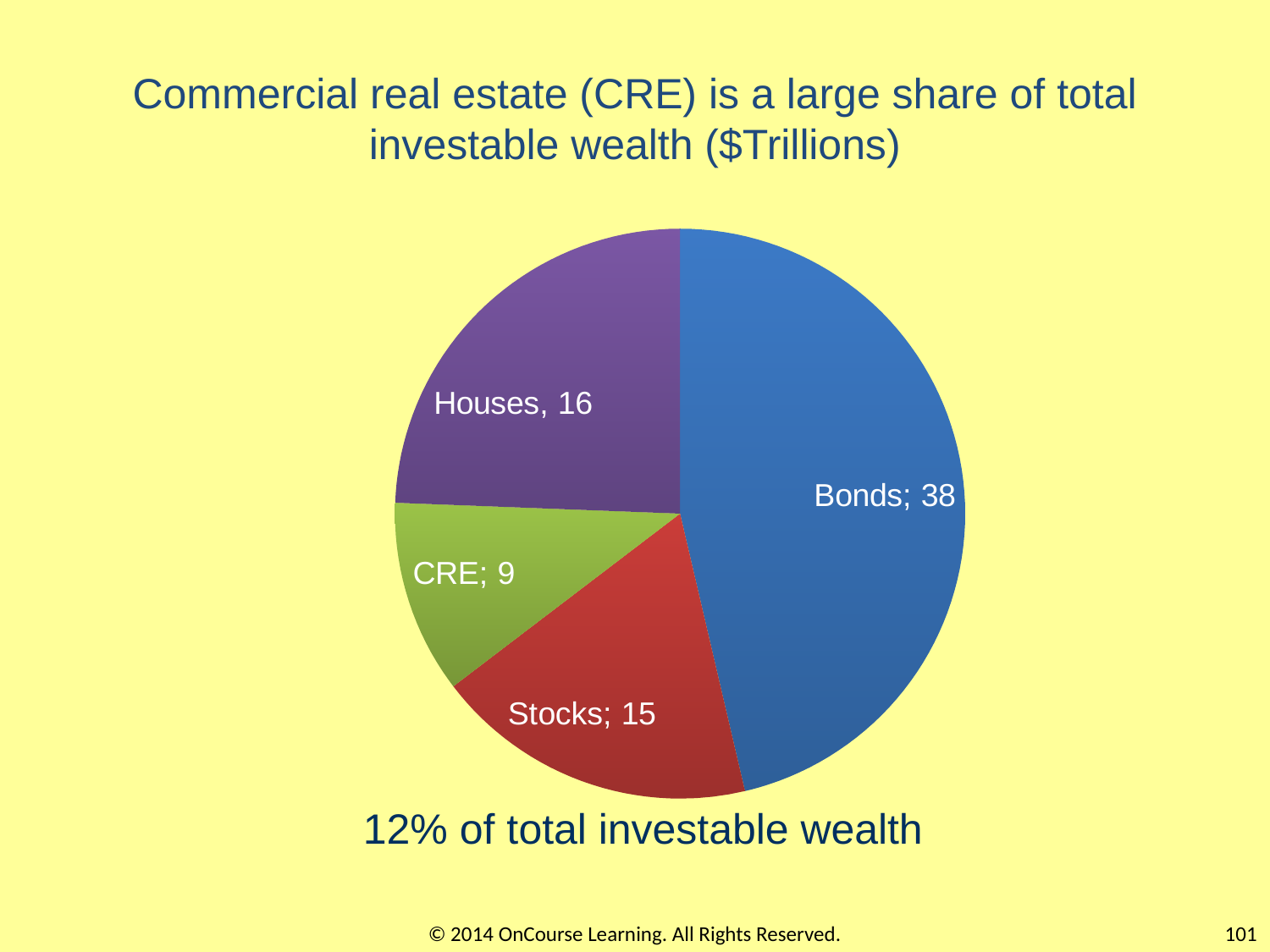
Which category has the smallest slice of the pie chart? CRE What is the value for Stocks in the pie chart? 15 Which category has the largest slice of the pie chart? Bonds According to the slide, what share of total investable wealth is CRE? 12% What is the value for Bonds in the pie chart? 38 What kind of chart is shown on the slide? Pie chart What is the value for CRE in the pie chart? 9 What is the difference between the values for Stocks and CRE? 6 Which is larger, the value for Houses or the value for Stocks? Houses How many categories are shown in the pie chart? 4 What is the difference between the values for Bonds and Houses? 22 What is the value for Houses in the pie chart? 16